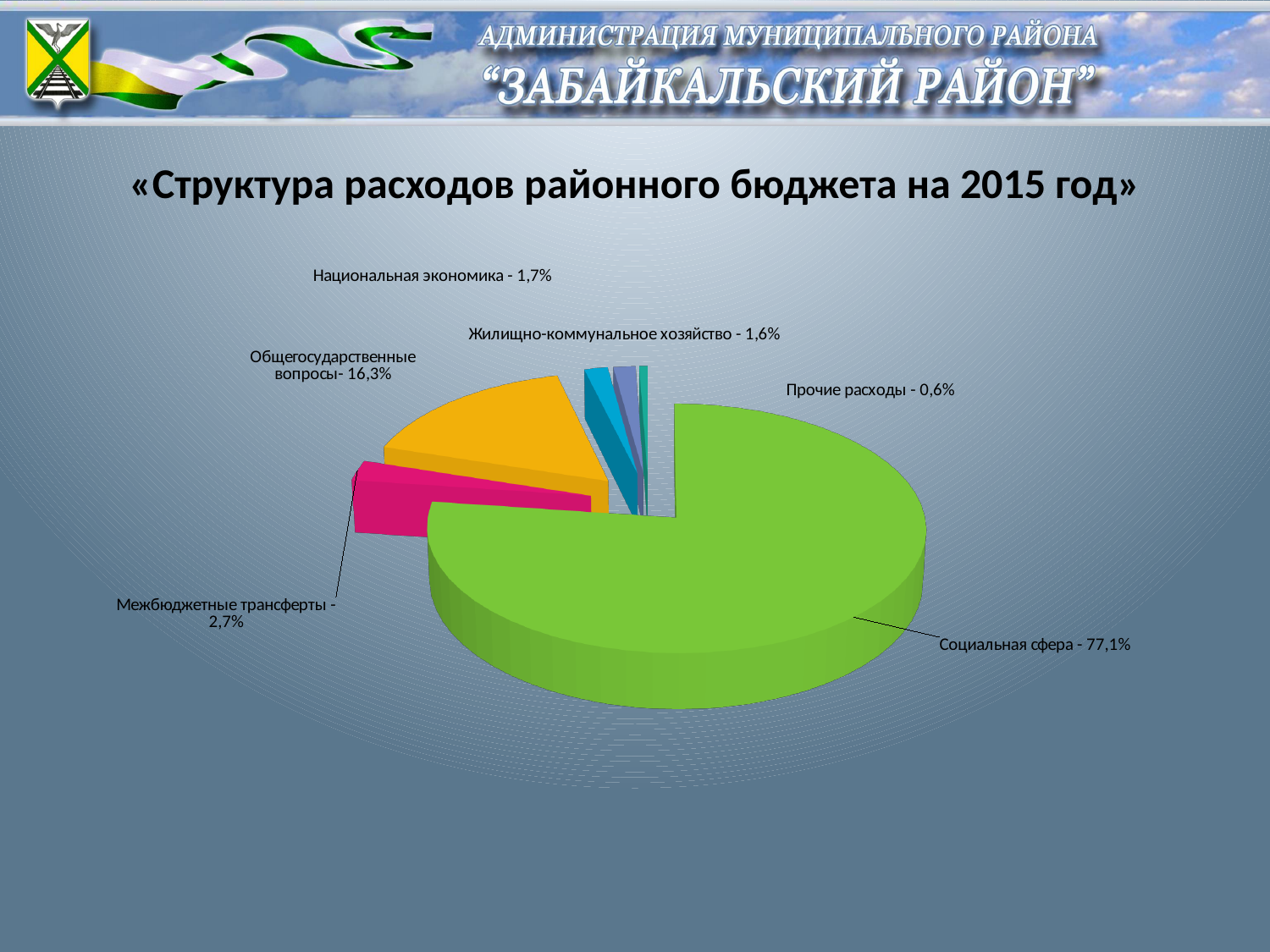
Which category has the smallest share of expenditures? Прочие расходы What share is shown for Межбюджетные трансферты? 2,7% What is the title of the chart on the slide? «Структура расходов районного бюджета на 2015 год» What share is shown for Прочие расходы? 0,6% What kind of chart is shown on the slide? Pie chart What share of the district budget expenditures is Социальная сфера? 77,1% What is the difference in percentage points between Социальная сфера and Общегосударственные вопросы? 60,8 Which category has the largest share of expenditures? Социальная сфера What share is shown for Национальная экономика? 1,7% How many categories are shown in the pie chart? 6 What share is shown for Общегосударственные вопросы? 16,3% What share is shown for Жилищно-коммунальное хозяйство? 1,6%